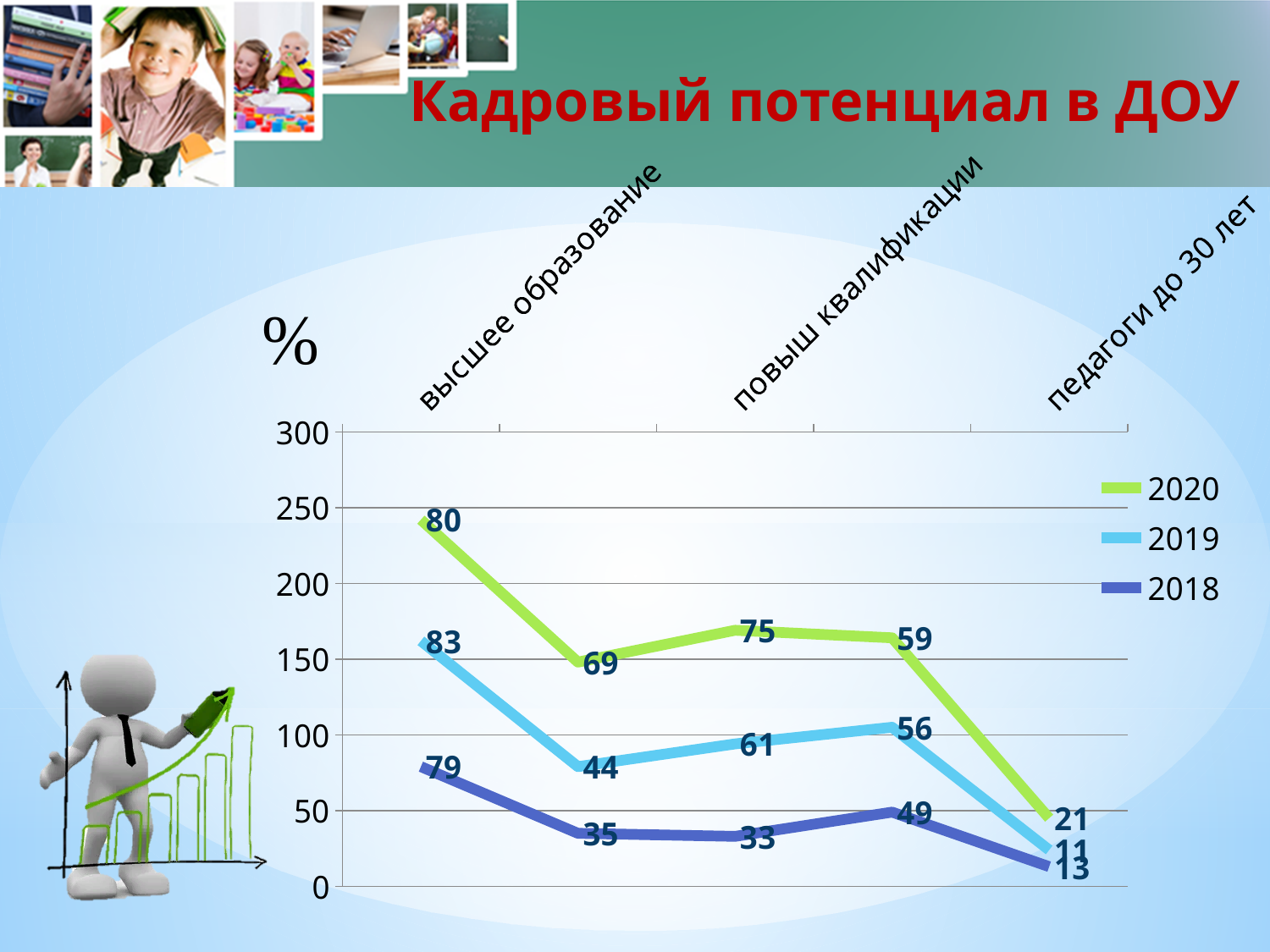
What is the highest labelled value on the 2020 line? 80 What is the title of the slide containing the chart? Кадровый потенциал в ДОУ How many series does the legend list? 3 What is the first (leftmost) data label on the 2020 line? 80 What is the lowest labelled value on the 2019 line? 11 What kind of chart is shown on the slide? line chart What is the last (rightmost) data label on the 2019 line? 11 At the first data point, which series has the larger labelled value, 2019 or 2020? 2019 What is the fourth data label on the 2018 line? 49 How many data points does each line have? 5 What is the difference between the first and last labelled values on the 2020 line (80 and 21)? 59 What is the last (rightmost) data label on the 2018 line? 13